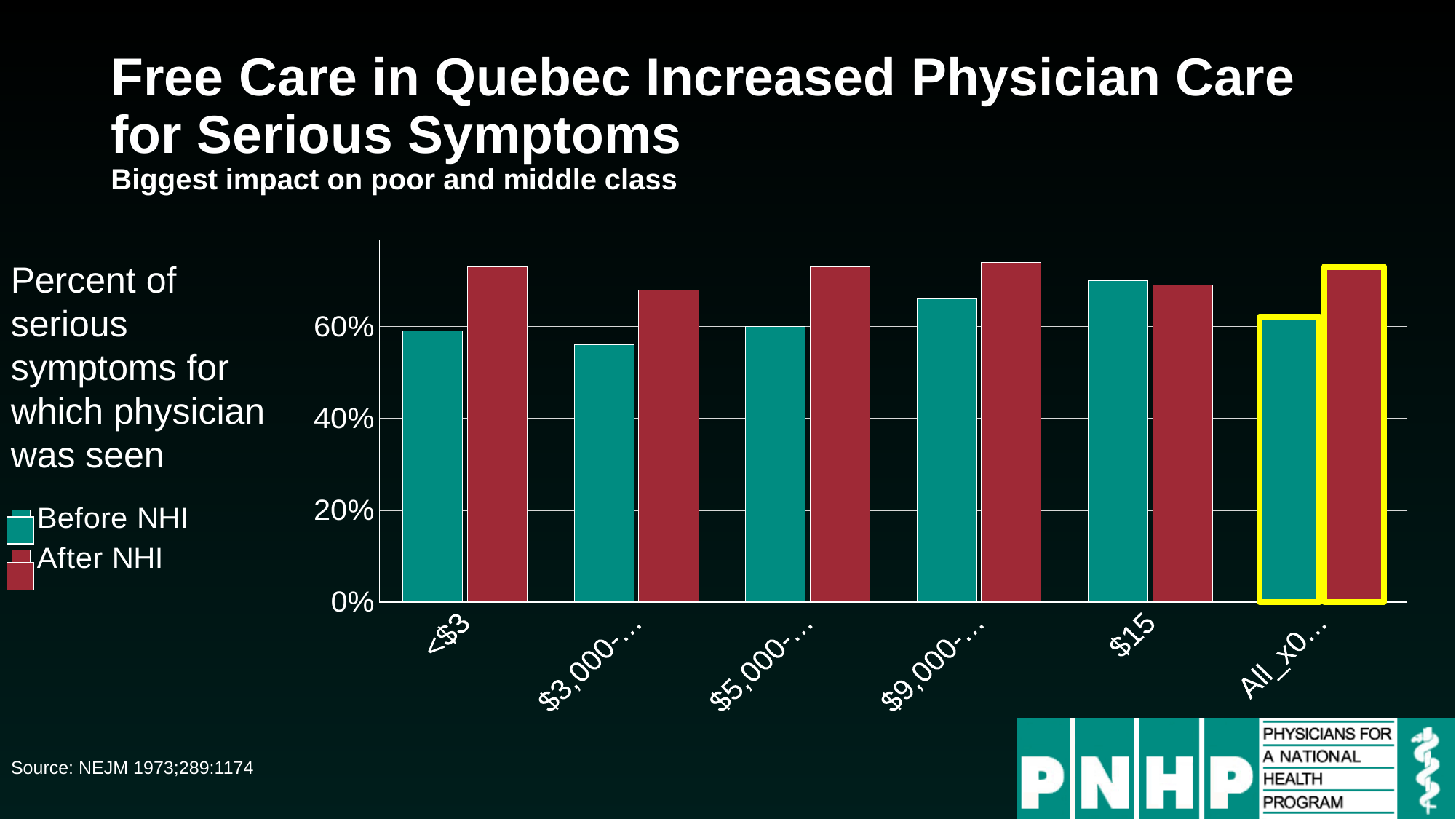
Is the Before NHI value for "$3,000-…" greater or less than 60%? less Is the After NHI value for "$3,000-…" greater or less than 40%? greater For the "$3,000-…" category, which is larger: Before NHI or After NHI? After NHI What are the two legend entries? Before NHI and After NHI Is the Before NHI value for "$15" greater or less than 60%? greater How many categories are shown along the x axis? 6 For the "$5,000-…" category, which is larger: Before NHI or After NHI? After NHI Which series is shown in teal? Before NHI How many series does the legend list? 2 For the "<$3" category, which is larger: Before NHI or After NHI? After NHI What kind of chart is shown on the slide? bar chart